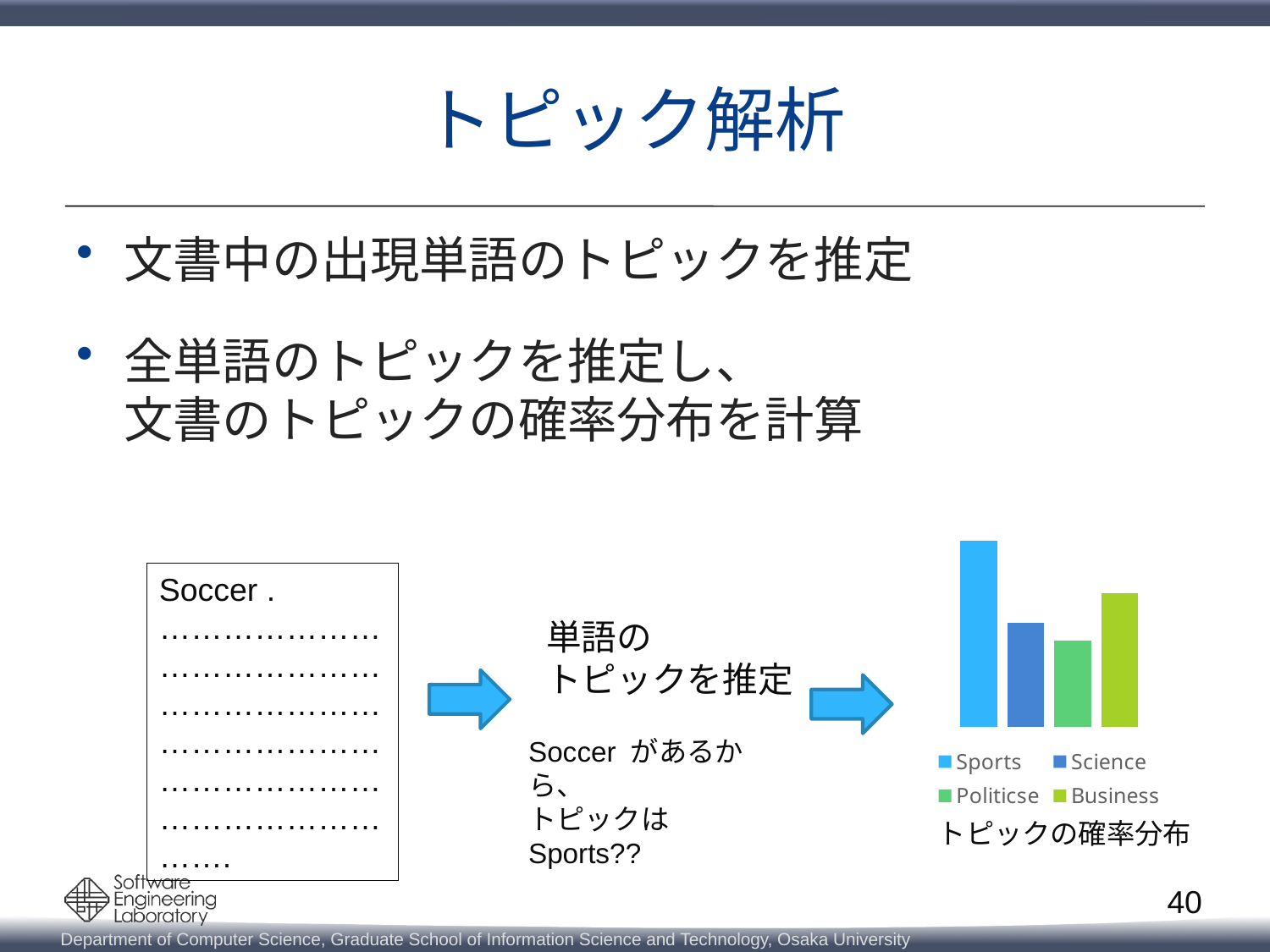
Which topic has the shortest bar in the chart? Politicse What are the four legend entries of the chart, in order? Sports, Science, Politicse, Business How many series does the chart's legend list? 4 What colour is the Business bar in the chart? yellow-green What kind of chart is shown on the slide? bar chart Which bar is taller, Sports or Business? Sports How many bars are plotted in the chart? 4 Which topic has the tallest bar in the chart? Sports Which bar is taller, Science or Politicse? Science Which bar is taller, Science or Business? Business